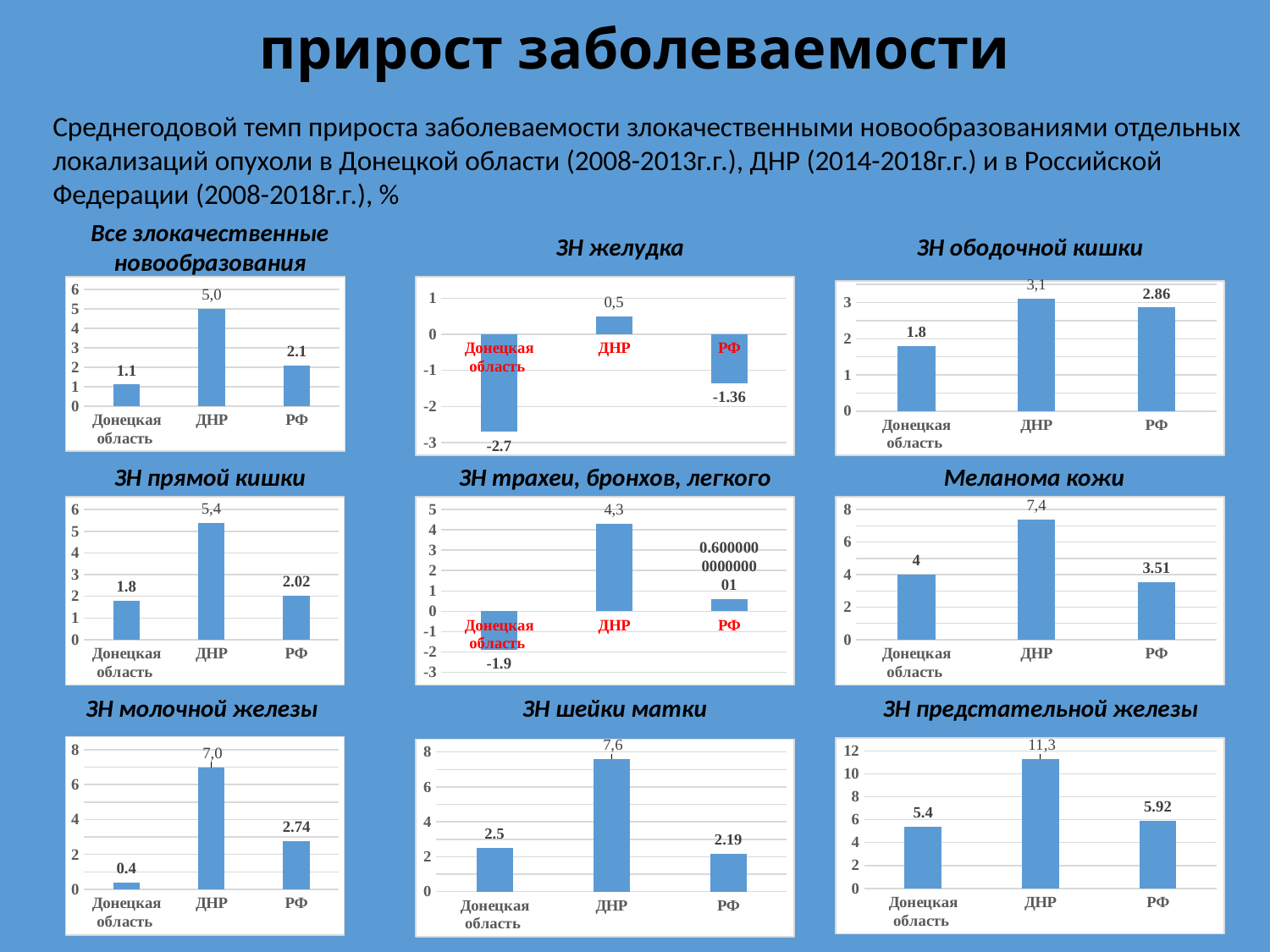
How many charts are shown on the slide? 9 In the chart titled "ЗН ободочной кишки", which category has the highest value? ДНР In the chart titled "ЗН молочной железы", which is larger, the value for Донецкая область or the value for РФ? РФ In the chart titled "Все злокачественные новообразования", what is the value for ДНР? 5,0 In the chart titled "Меланома кожи", what is the difference between the values for ДНР and Донецкая область? 3.4 How many categories are shown in the chart titled "ЗН желудка"? 3 In the chart titled "ЗН шейки матки", what is the value for ДНР? 7,6 In the chart titled "ЗН предстательной железы", what is the difference between the values for ДНР and Донецкая область? 5.9 In the chart titled "ЗН трахеи, бронхов, легкого", which category has the lowest value? Донецкая область What kind of chart is the one titled "Меланома кожи"? Bar chart In the chart titled "ЗН желудка", what is the value for Донецкая область? -2.7 In the chart titled "ЗН прямой кишки", what is the value for РФ? 2.02